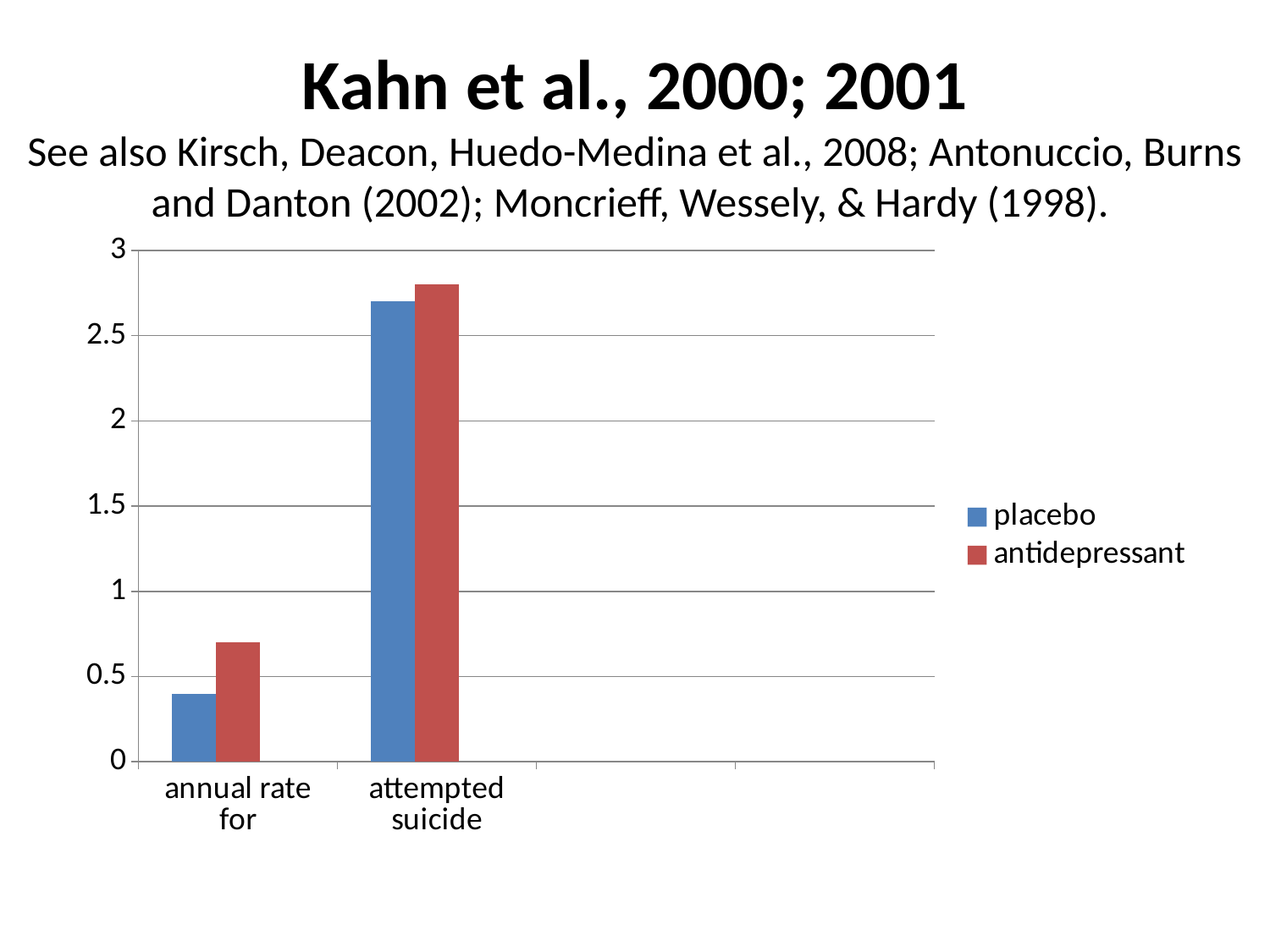
Is the placebo value for 'attempted suicide' greater or less than 2.5? greater Is the antidepressant value for 'annual rate for' greater or less than 1? less How many series does the legend list? 2 Is the placebo value for 'annual rate for' greater or less than 0.5? less How many labelled categories are shown on the x axis? 2 Which colour represents the placebo series? blue What kind of chart is shown on the slide? bar chart Which category has the higher placebo value, 'annual rate for' or 'attempted suicide'? attempted suicide What are the two series named in the legend? placebo and antidepressant For 'annual rate for', which series has the larger value, placebo or antidepressant? antidepressant